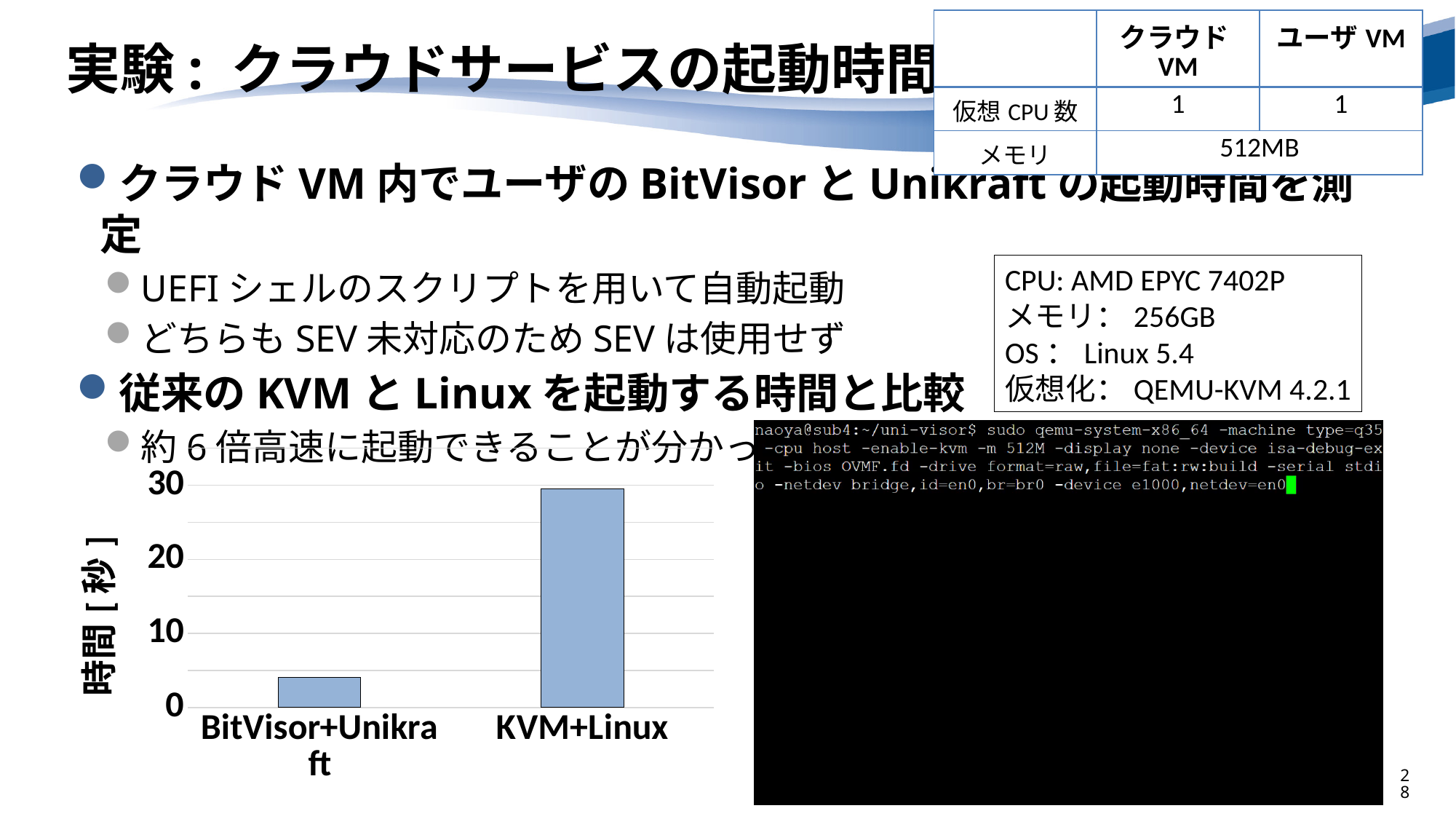
How many categories are plotted in the bar chart? 2 What is the label of the vertical axis of the bar chart? 時間[秒] Is the value for BitVisor+Unikraft greater or less than 10? less Is the value for KVM+Linux greater or less than 20? greater Which is larger in the bar chart, the value for BitVisor+Unikraft or the value for KVM+Linux? KVM+Linux Which category has the highest value in the bar chart? KVM+Linux What is the highest tick value shown on the vertical axis of the bar chart? 30 Which category has the lowest value in the bar chart? BitVisor+Unikraft What kind of chart is shown on the slide? bar chart